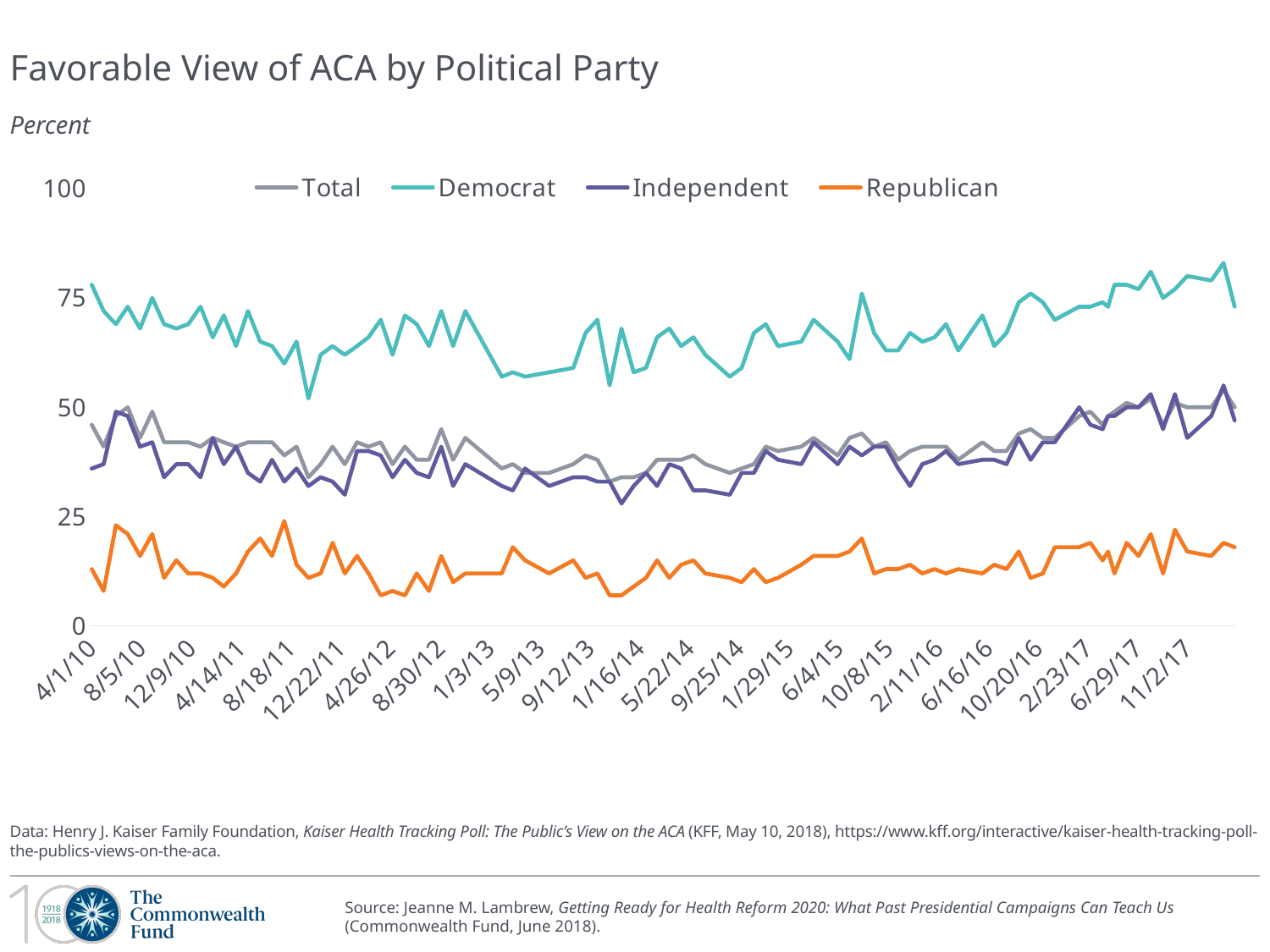
Which political party series has the highest values across the chart? Democrat Is the value for Democrat at 4/1/10 greater or less than 50? greater Is the value for Total at 1/16/14 greater or less than 50? less How many series does the legend list? 4 Which series has the lowest values across the chart? Republican What kind of chart is shown on the slide? Line chart What is the title of the chart? Favorable View of ACA by Political Party Is the value for Independent at 6/29/17 greater or less than 25? greater Does the Democrat series generally rise or fall between 9/25/14 and 11/2/17? rise At 11/2/17, which is larger, the Democrat value or the Republican value? Democrat Which series does the legend list between Democrat and Republican? Independent